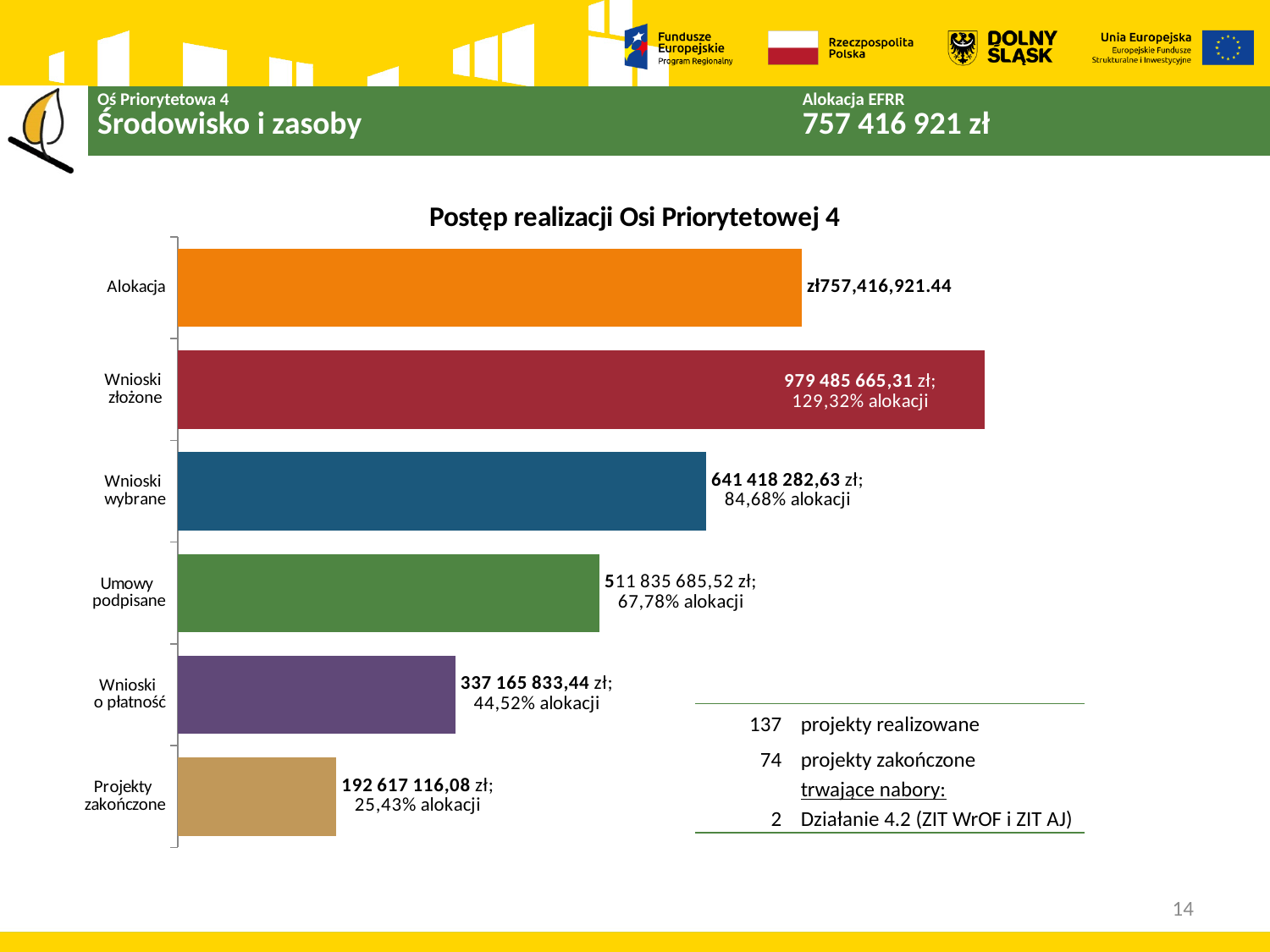
What value is shown for Wnioski złożone? 979 485 665,31 zł What value is shown for Umowy podpisane? 511 835 685,52 zł How many categories does the chart show? 6 Which category has the lowest value? Projekty zakończone What colour is the bar for Alokacja? orange Which is larger, the value for Wnioski wybrane or the value for Umowy podpisane? Wnioski wybrane What is the title of the chart? Postęp realizacji Osi Priorytetowej 4 What percentage of the allocation do Projekty zakończone represent? 25,43% What percentage of the allocation do Wnioski wybrane represent? 84,68% What kind of chart is shown on the slide? bar chart What value is shown for Wnioski o płatność? 337 165 833,44 zł Which category has the highest value? Wnioski złożone